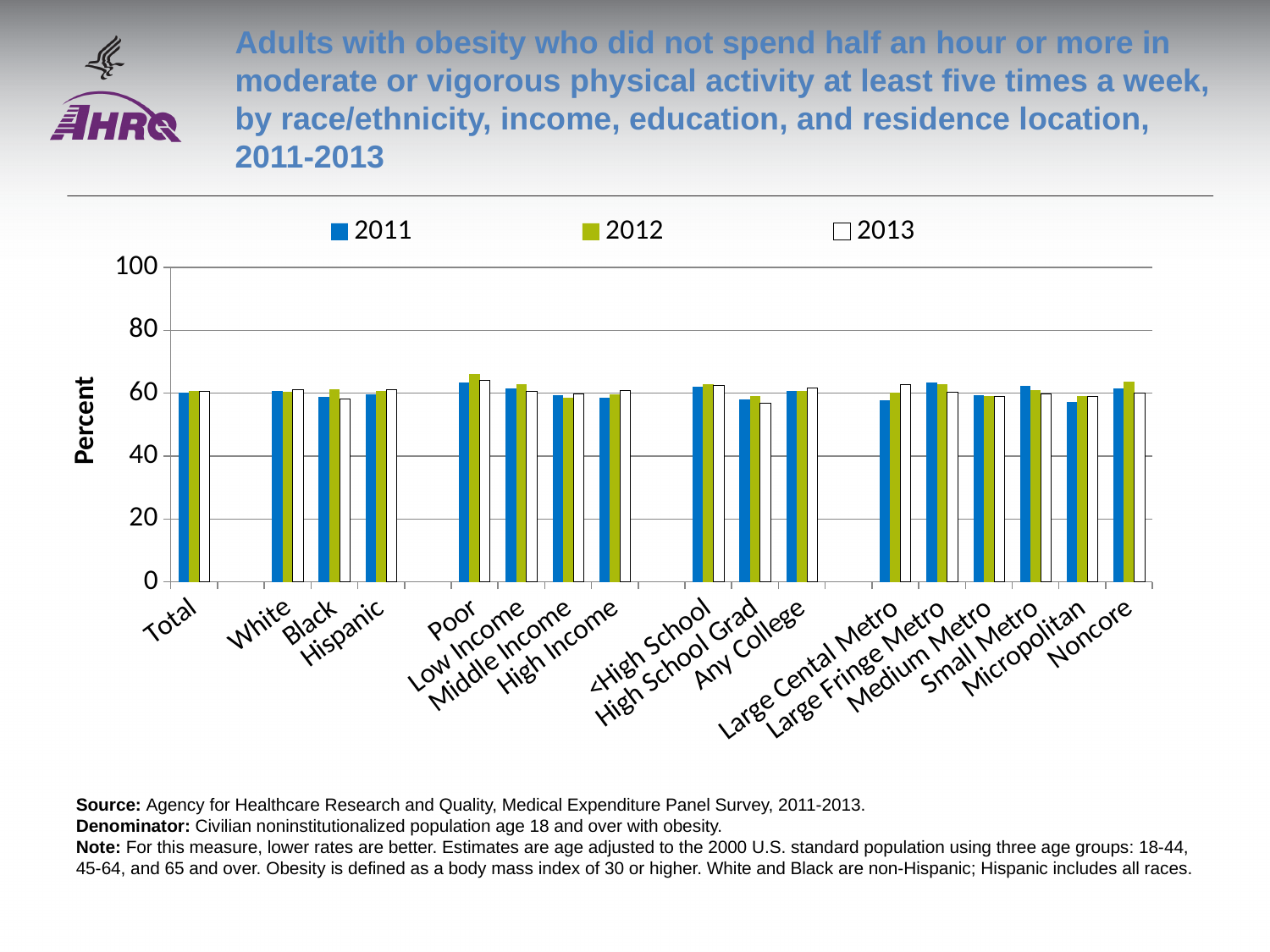
Is the value for Noncore in 2013 greater or less than 80? less Is the value for Micropolitan in 2011 greater or less than 40? greater Is the value for Total in 2011 greater or less than 40? greater How many categories are shown along the x axis? 17 How many series does the legend list? 3 What is the label on the y axis? Percent What kind of chart is shown on the slide? bar chart Which years are listed in the legend? 2011, 2012, 2013